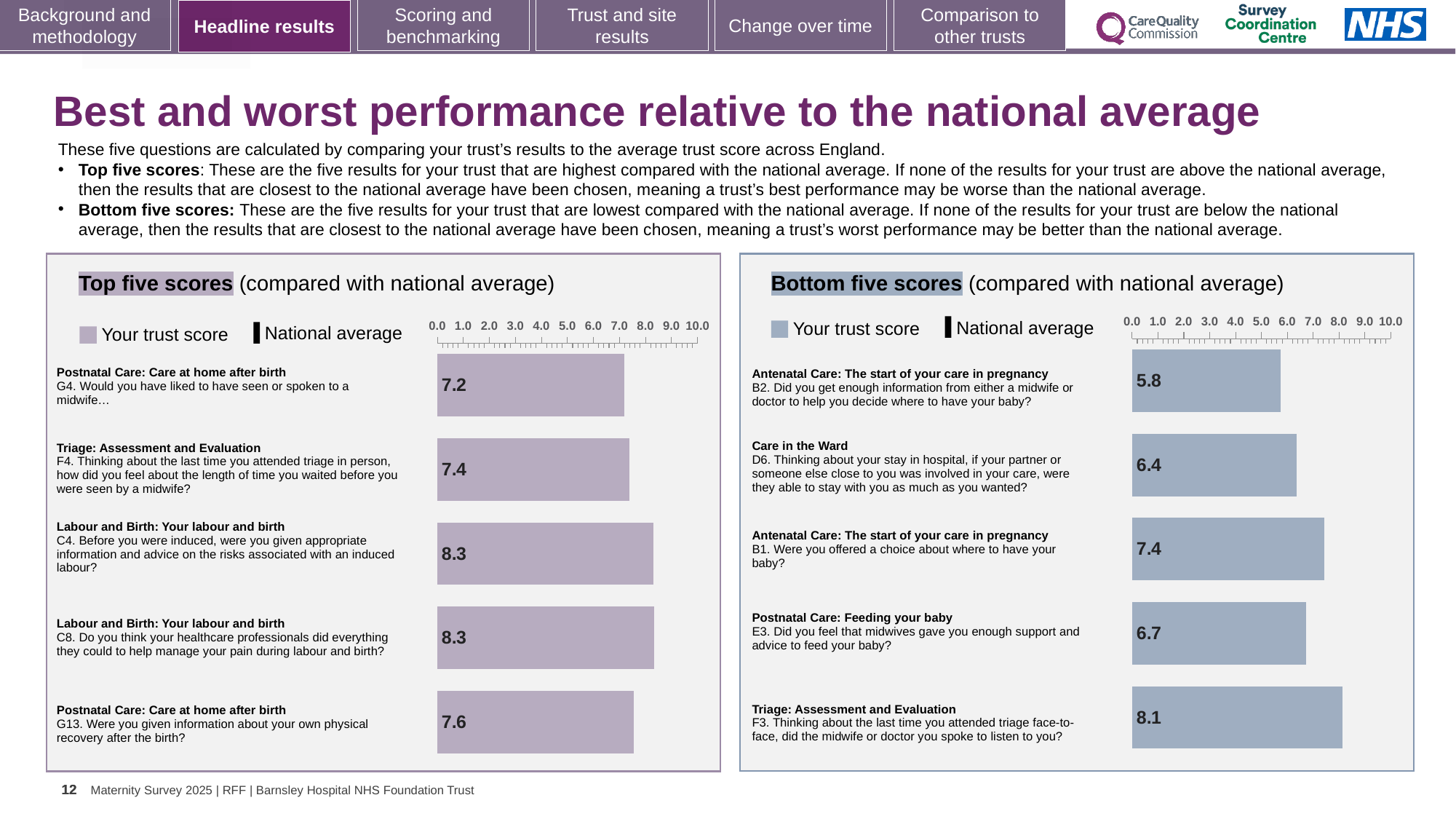
How many questions are shown in the Top five scores chart? 5 In the Bottom five scores chart, which question has the highest trust score? F3 (8.1) In the Top five scores chart, what is the difference between the trust score for C4 and the trust score for G4? 1.1 In the Bottom five scores chart, what is the difference between the trust score for F3 and the trust score for B2? 2.3 In the Bottom five scores chart, which question has the lowest trust score? B2 (5.8) In the Top five scores chart, which question has the lowest trust score? G4 (7.2) In the Bottom five scores chart, is the trust score for B2 greater or less than 6.0? less In the Bottom five scores chart, what is the trust score for B2 (Did you get enough information from either a midwife or doctor to help you decide where to have your baby)? 5.8 In the Top five scores chart, what is the trust score for G4 (Would you have liked to have seen or spoken to a midwife)? 7.2 In the Bottom five scores chart, which has the larger trust score, D6 or E3? E3 (6.7) What type of chart is used in the Top five scores panel? Bar chart How many entries does the legend of the Bottom five scores chart list? 2